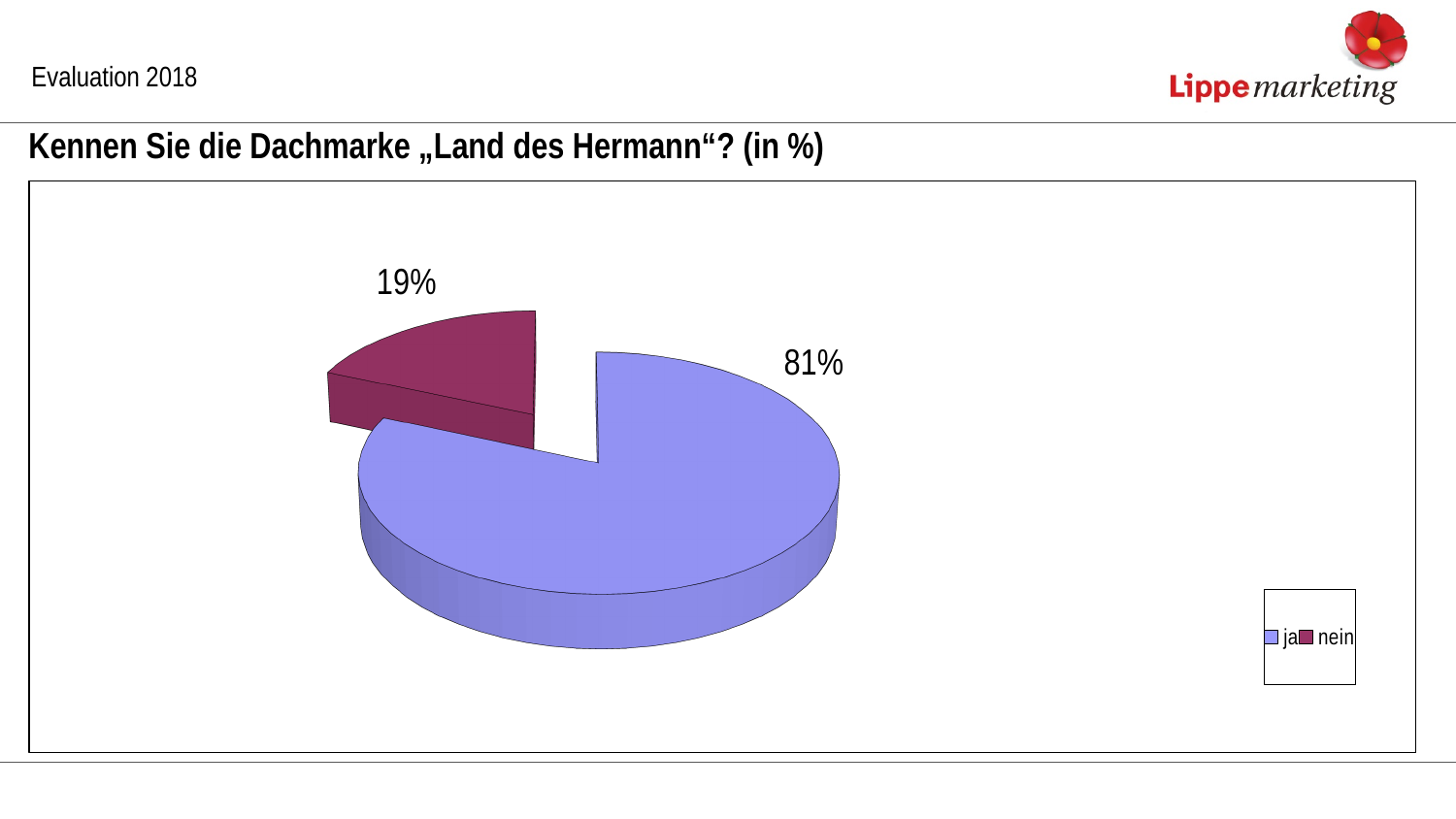
What kind of chart is shown on the slide? pie chart What colour is the "ja" slice? blue What share of the pie does the "nein" slice represent? 19% What percentage of respondents answered "ja"? 81% How many entries does the legend list? 2 Which answer has the largest share of the pie? ja Which answer has the smallest share of the pie? nein What question does the chart title ask? Kennen Sie die Dachmarke „Land des Hermann“? (in %) What is the difference in percentage points between the "ja" and "nein" slices? 62 Which slice is larger, "ja" or "nein"? ja What percentage of respondents answered "nein"? 19% How many slices does the pie chart have? 2